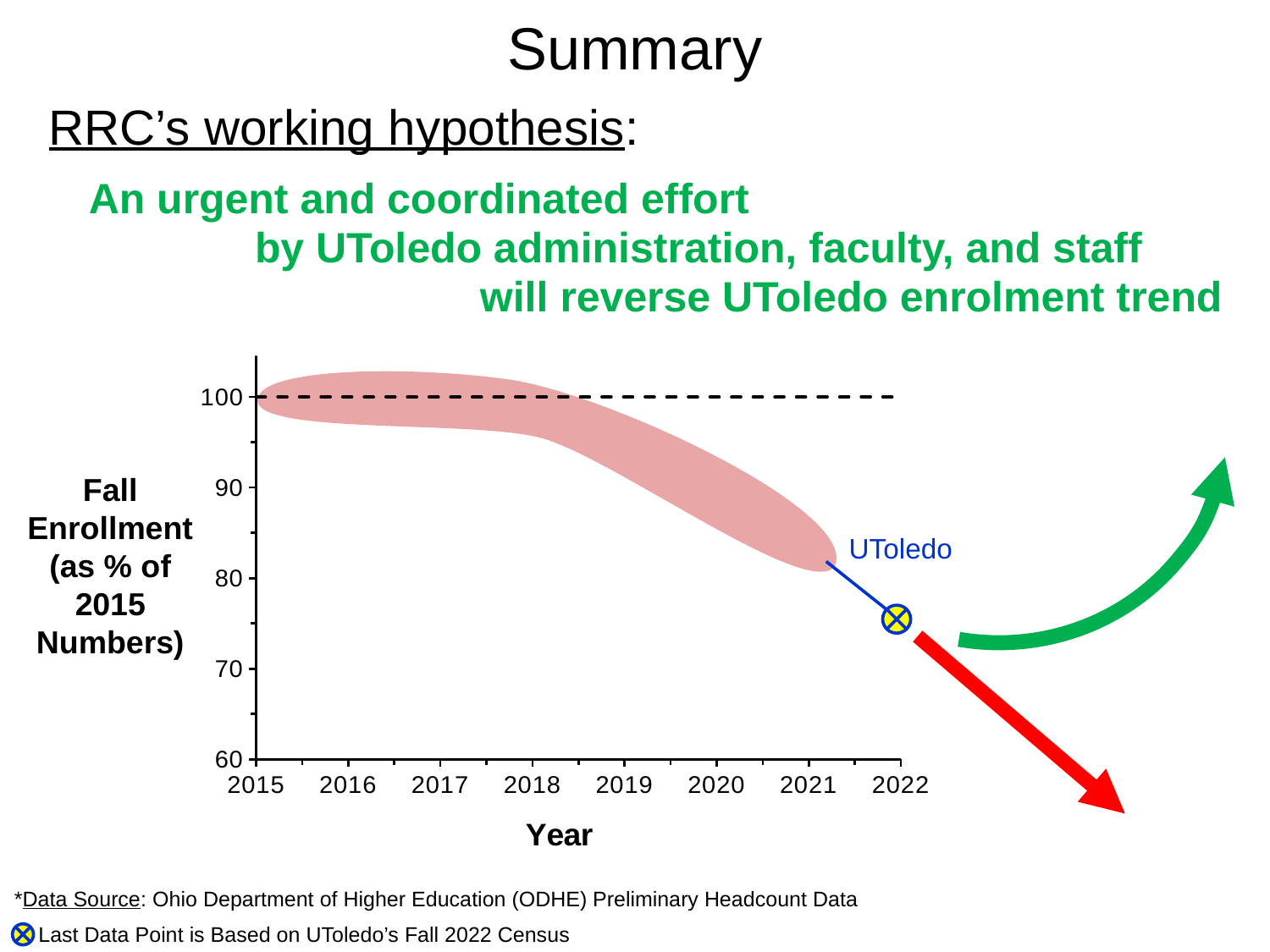
What is the first year shown on the x axis? 2015 Is the UToledo value for 2022 greater or less than 70? greater What is the lowest value shown on the y axis? 60 How many years are labelled on the x axis of the chart? 8 Does UToledo's fall enrollment rise or fall from 2015 to 2022 on the chart? fall Is the UToledo value for 2022 greater or less than 80? less At what value is the horizontal dashed line drawn on the chart? 100 What kind of chart is shown on the slide? line chart Is the UToledo value for 2021 greater or less than 90? less Which year has the lowest UToledo enrollment value on the chart? 2022 What is the label of the x axis? Year